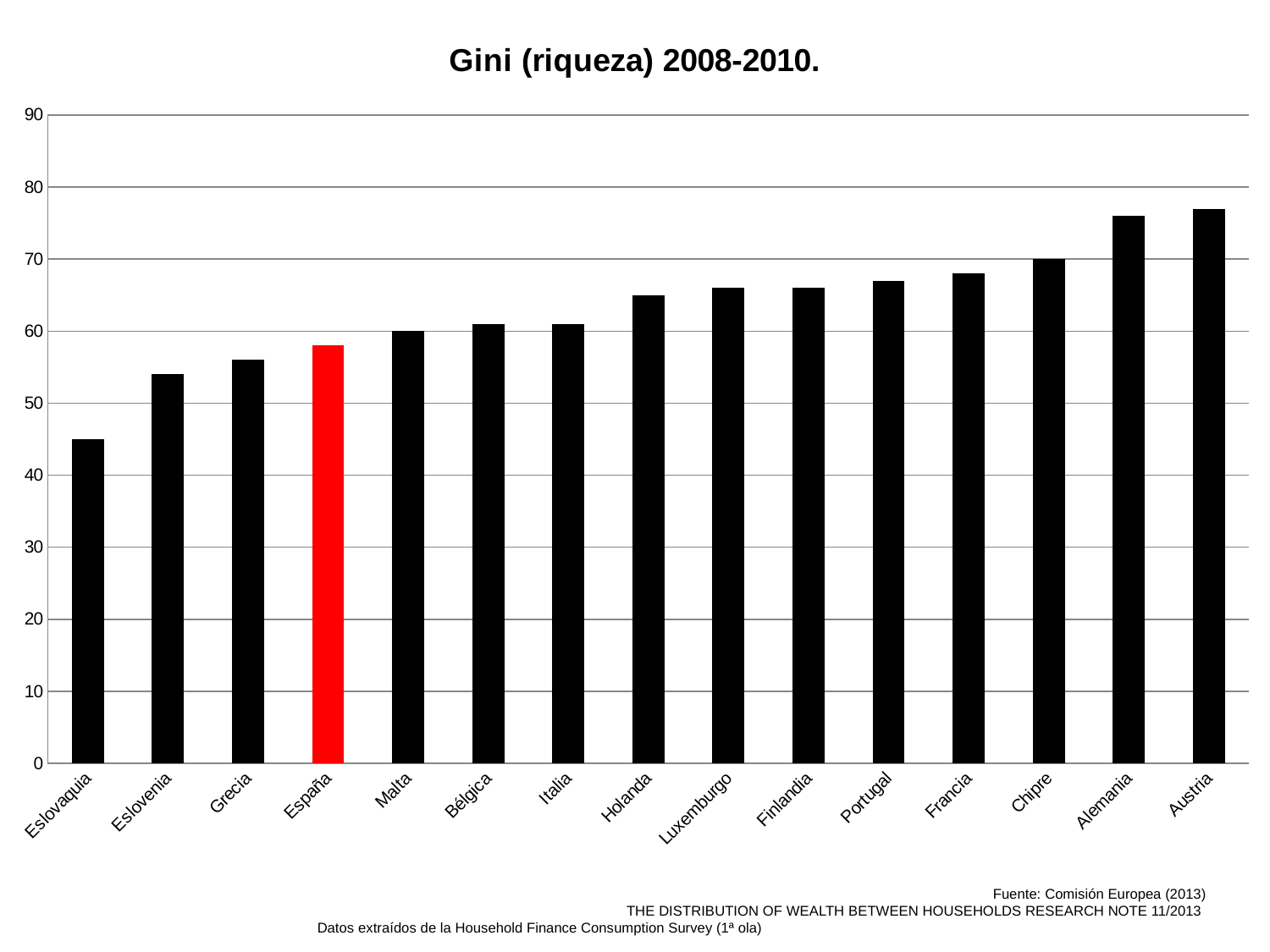
What is the value for Chipre? 70 Do the values generally rise or fall from left to right along the x axis? rise Which country's bar is coloured red instead of black? España Is the value for Alemania greater or less than 70? greater Is the value for Eslovaquia greater or less than 50? less How many countries are shown on the x axis of the chart? 15 What is the value for Malta? 60 What kind of chart is shown on the slide? bar chart Is the value for Holanda greater or less than 60? greater What is the title of the chart? Gini (riqueza) 2008-2010. Which country has the lowest value in the chart? Eslovaquia